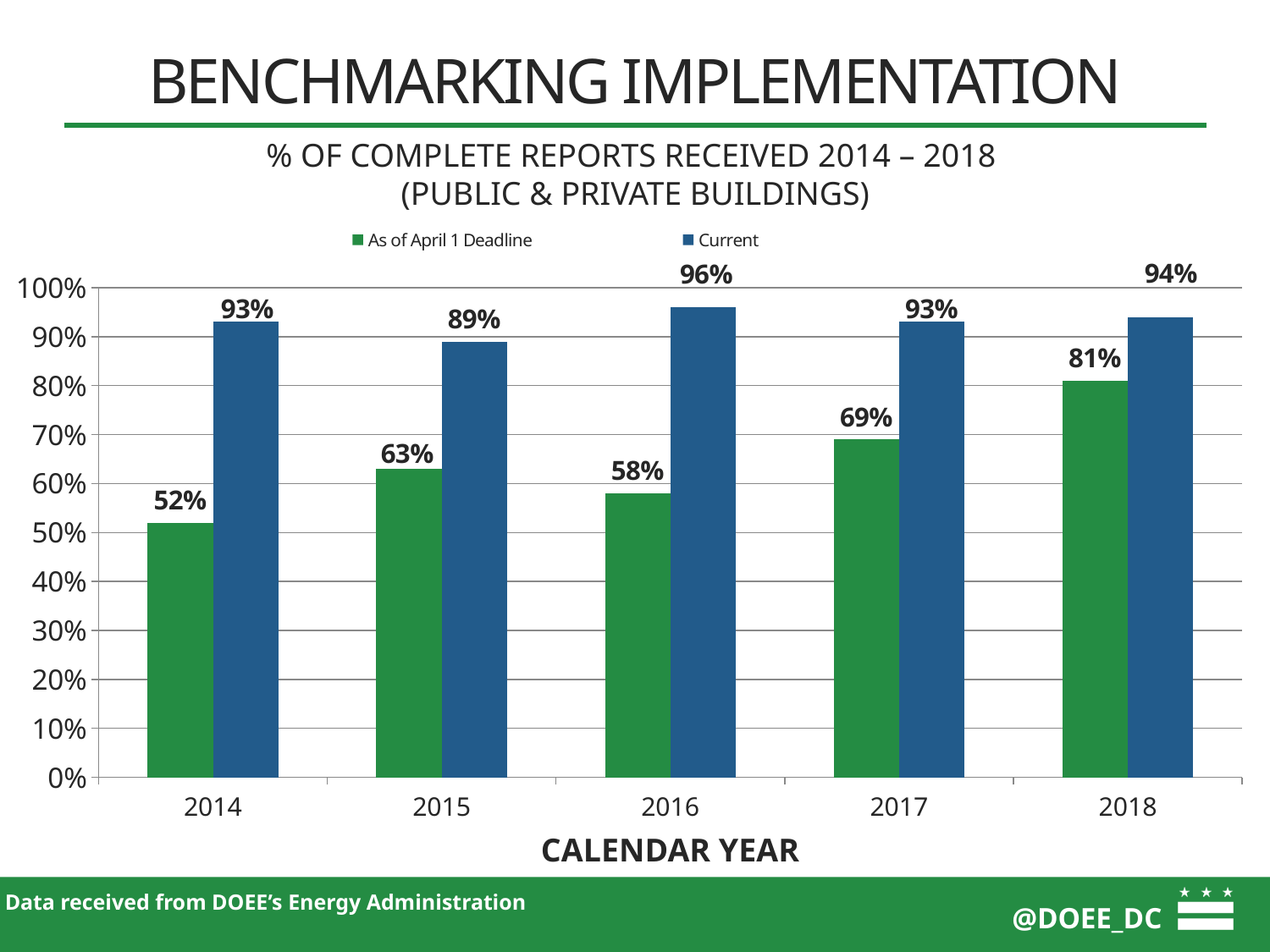
What is the 'As of April 1 Deadline' value for 2018? 81% What is the difference between the 'Current' and 'As of April 1 Deadline' values in 2017? 24% What is the value for 'As of April 1 Deadline' in 2014? 52% Does the 'Current' value rise or fall from 2014 to 2015? Fall How many series does the legend list? 2 What kind of chart is shown on the slide? Bar chart What is the label of the x axis? CALENDAR YEAR How many calendar years are shown on the x axis? 5 Which year has the highest 'Current' value? 2016 What is the 'Current' value for 2016? 96% Which is larger, the 'As of April 1 Deadline' value for 2015 or for 2016? 2015 Which year has the lowest 'As of April 1 Deadline' value? 2014